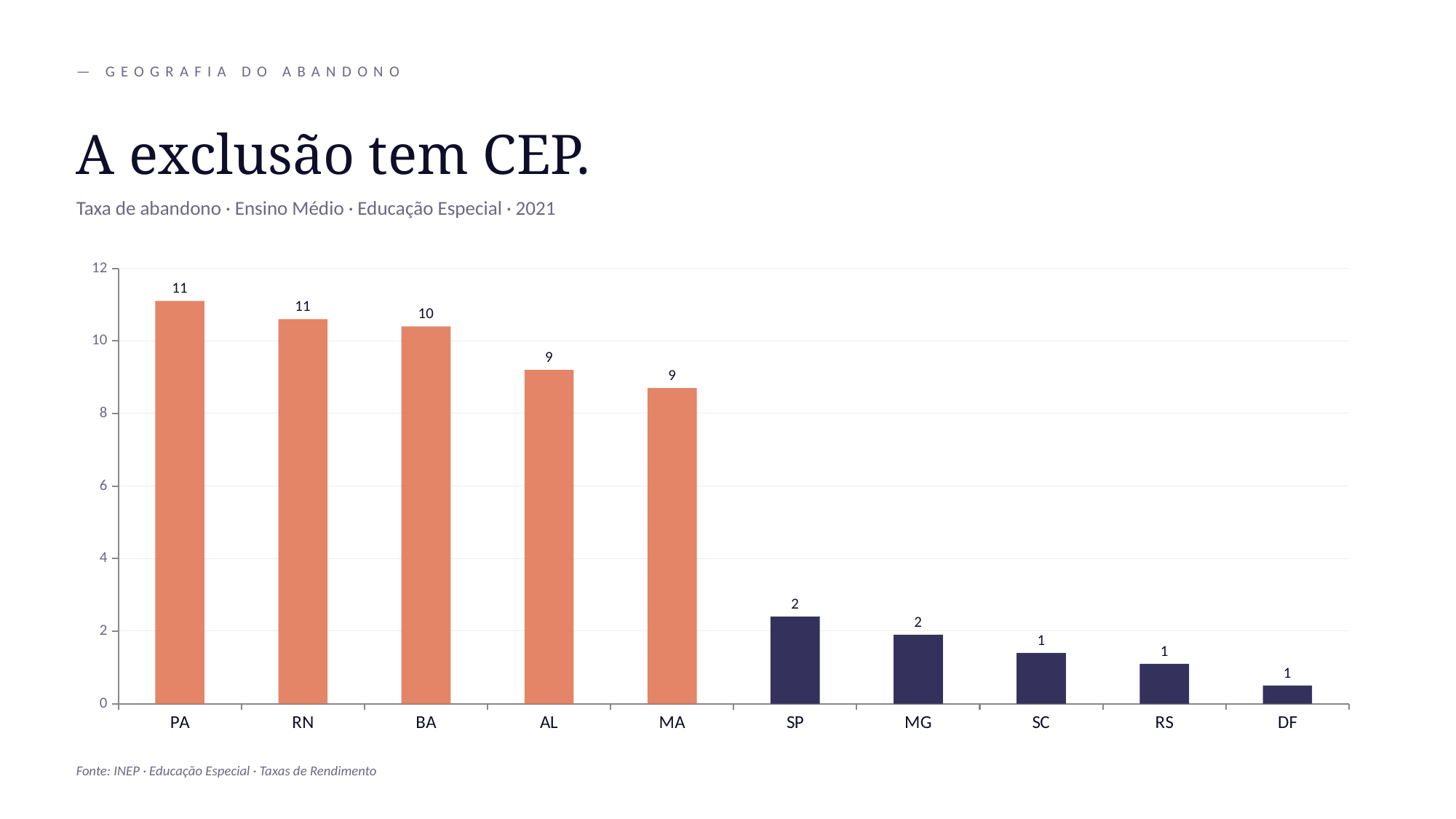
What kind of chart is shown on the slide? Bar chart Which state has the lowest abandonment rate in the chart? DF Which state has the highest abandonment rate in the chart? PA Do the values rise or fall from left to right along the x axis? Fall Which has a higher value, BA or AL? BA What is the difference between the labelled values for PA and DF? 10 What is the value shown for PA? 11 What is the value shown for SP? 2 Is the value for MA greater or less than 8? greater What is the value shown for BA? 10 What is the title of the slide above the chart? A exclusão tem CEP. How many states are shown on the x axis? 10